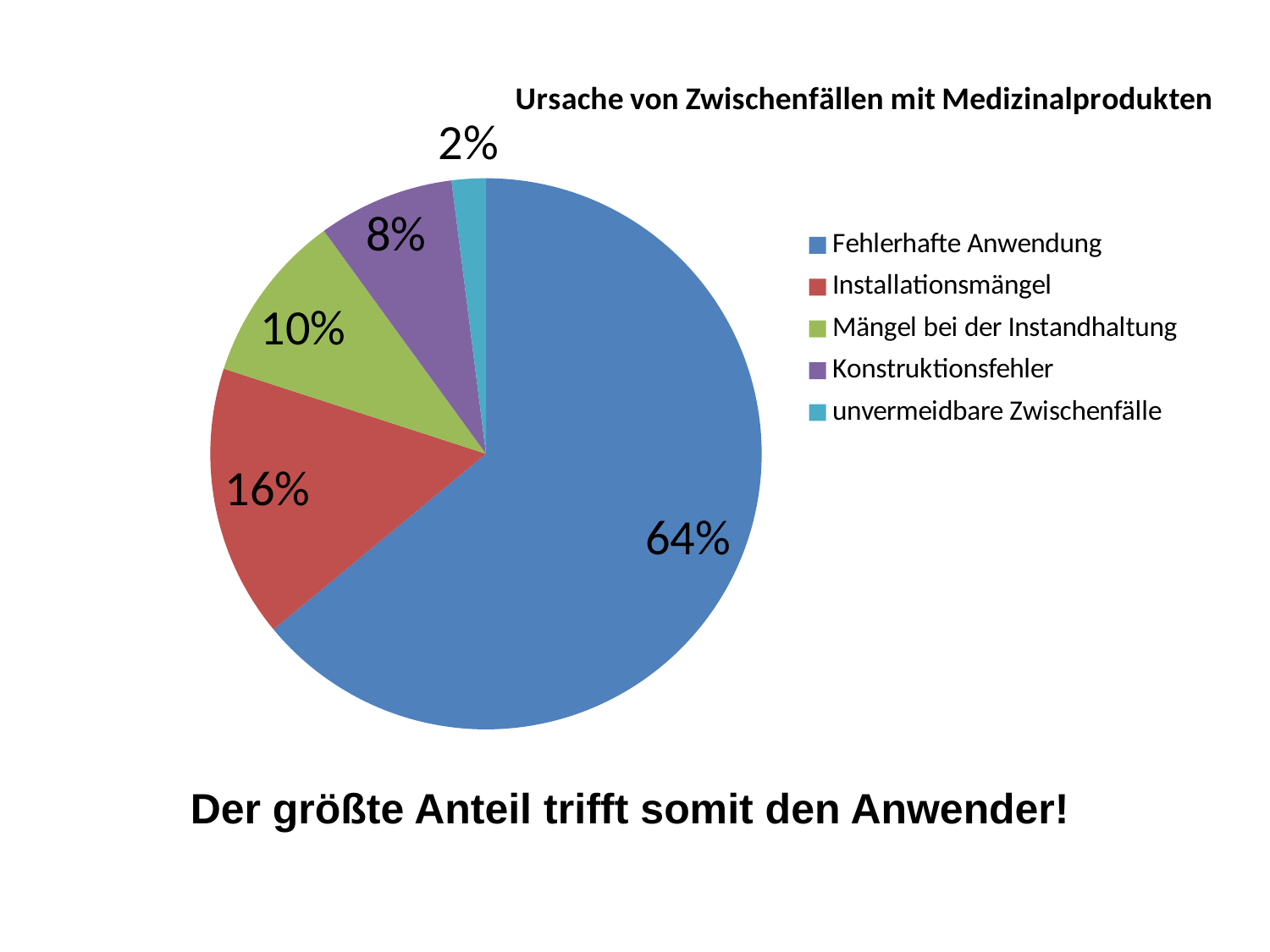
What is the value shown for Konstruktionsfehler? 8% What share of the pie does Fehlerhafte Anwendung account for? 64% What is the value shown for unvermeidbare Zwischenfälle? 2% What is the difference in percentage points between Fehlerhafte Anwendung and Installationsmängel? 48 What is the value shown for Mängel bei der Instandhaltung? 10% Which is larger, Mängel bei der Instandhaltung or Konstruktionsfehler? Mängel bei der Instandhaltung What is the value shown for Installationsmängel? 16% Which category has the smallest slice of the pie? unvermeidbare Zwischenfälle What is the title of the chart? Ursache von Zwischenfällen mit Medizinalprodukten What kind of chart is shown on the slide? Pie chart Which category has the largest slice of the pie? Fehlerhafte Anwendung How many categories does the pie chart show? 5